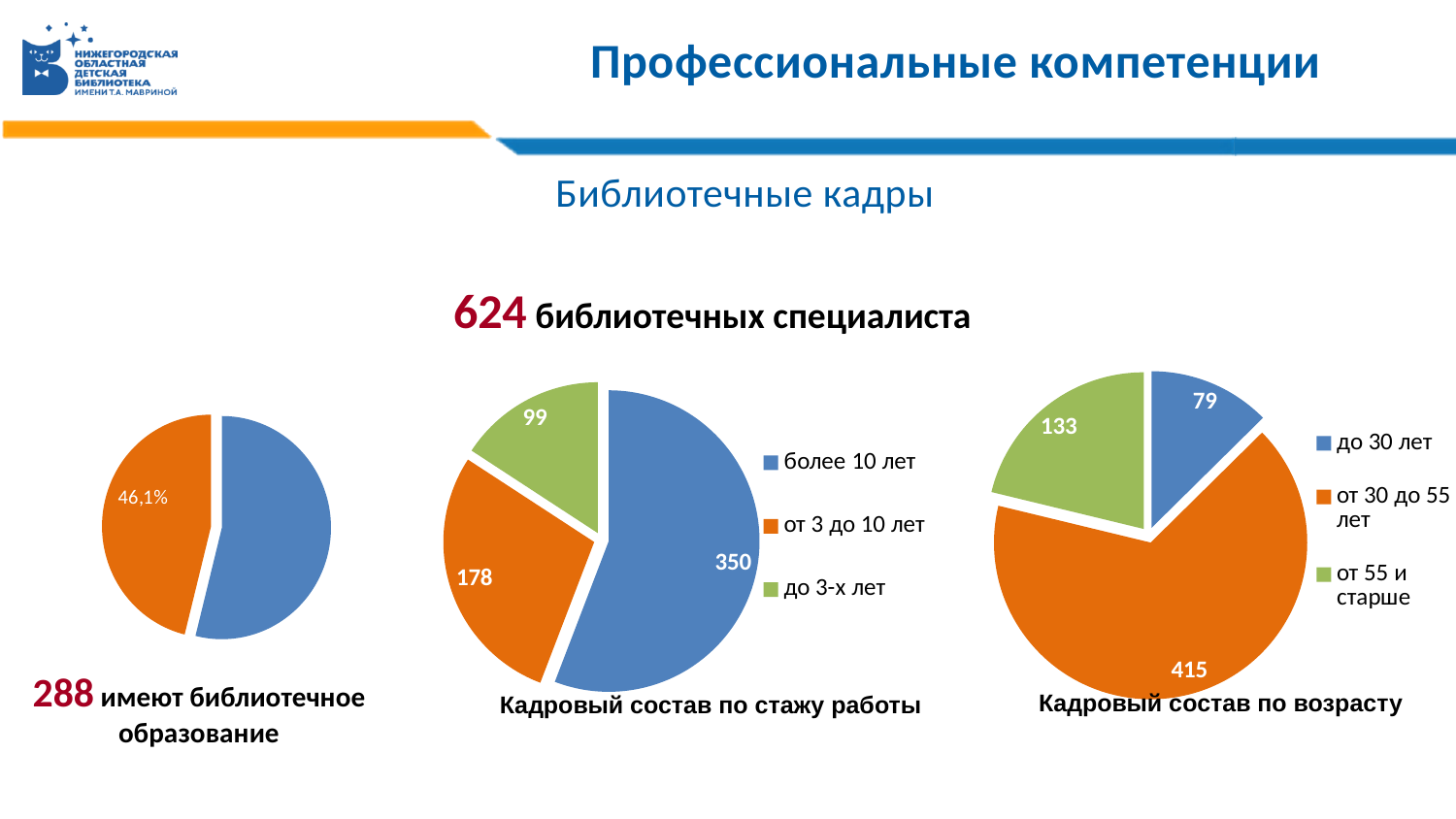
In the chart titled 'Кадровый состав по стажу работы', what is the value for 'до 3-х лет'? 99 In the chart titled 'Кадровый состав по стажу работы', what is the value for 'более 10 лет'? 350 In the chart titled 'Кадровый состав по возрасту', what is the value for 'до 30 лет'? 79 What kind of chart is 'Кадровый состав по возрасту'? pie chart In the chart titled 'Кадровый состав по возрасту', what is the value for 'от 30 до 55 лет'? 415 In the chart titled 'Кадровый состав по возрасту', which category has the smallest slice? до 30 лет How many categories does the legend of the chart titled 'Кадровый состав по стажу работы' list? 3 In the chart titled 'Кадровый состав по стажу работы', which category has the largest slice? более 10 лет In the chart titled 'Кадровый состав по возрасту', which is larger: 'от 55 и старше' or 'до 30 лет'? от 55 и старше What percentage is printed on the orange slice of the leftmost pie chart on the slide? 46,1% In the chart titled 'Кадровый состав по стажу работы', what is the difference between the values for 'более 10 лет' and 'от 3 до 10 лет'? 172 In the chart titled 'Кадровый состав по возрасту', what is the difference between the values for 'от 55 и старше' and 'до 30 лет'? 54